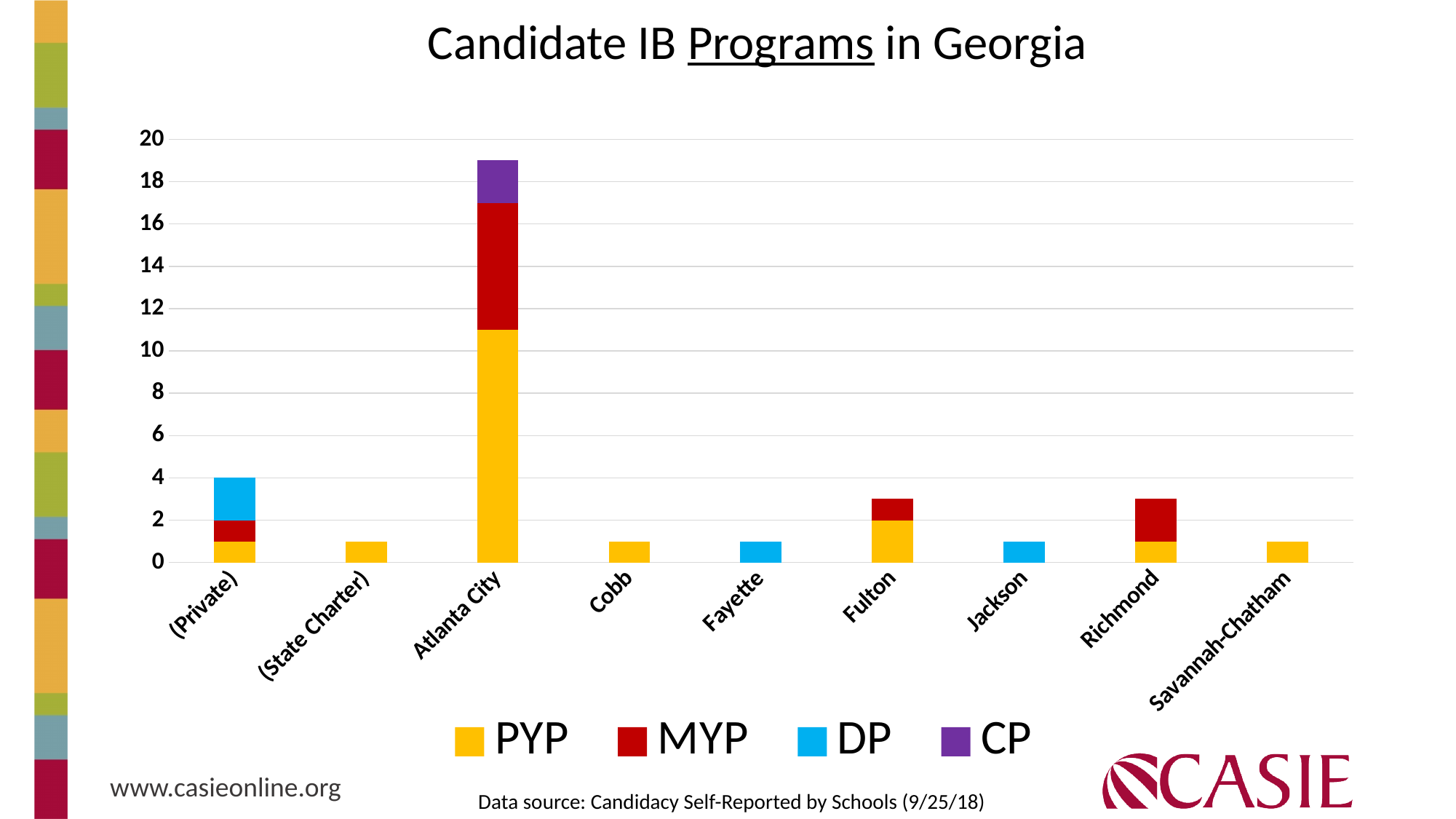
How many series does the legend list? 4 What kind of chart is shown on the slide? bar chart How many categories are shown on the x axis? 9 What is the title of the chart? Candidate IB Programs in Georgia Is the value for Cobb greater or less than 2? less Which has the larger total, Fulton or Cobb? Fulton Which category has the tallest stacked bar? Atlanta City Which has the larger total, Atlanta City or (Private)? Atlanta City Is the total for Fulton greater or less than 4? less What is the total height of the stacked bar for (Private)? 4 Is the total for Atlanta City greater or less than 18? greater What is the PYP value for Fulton? 2